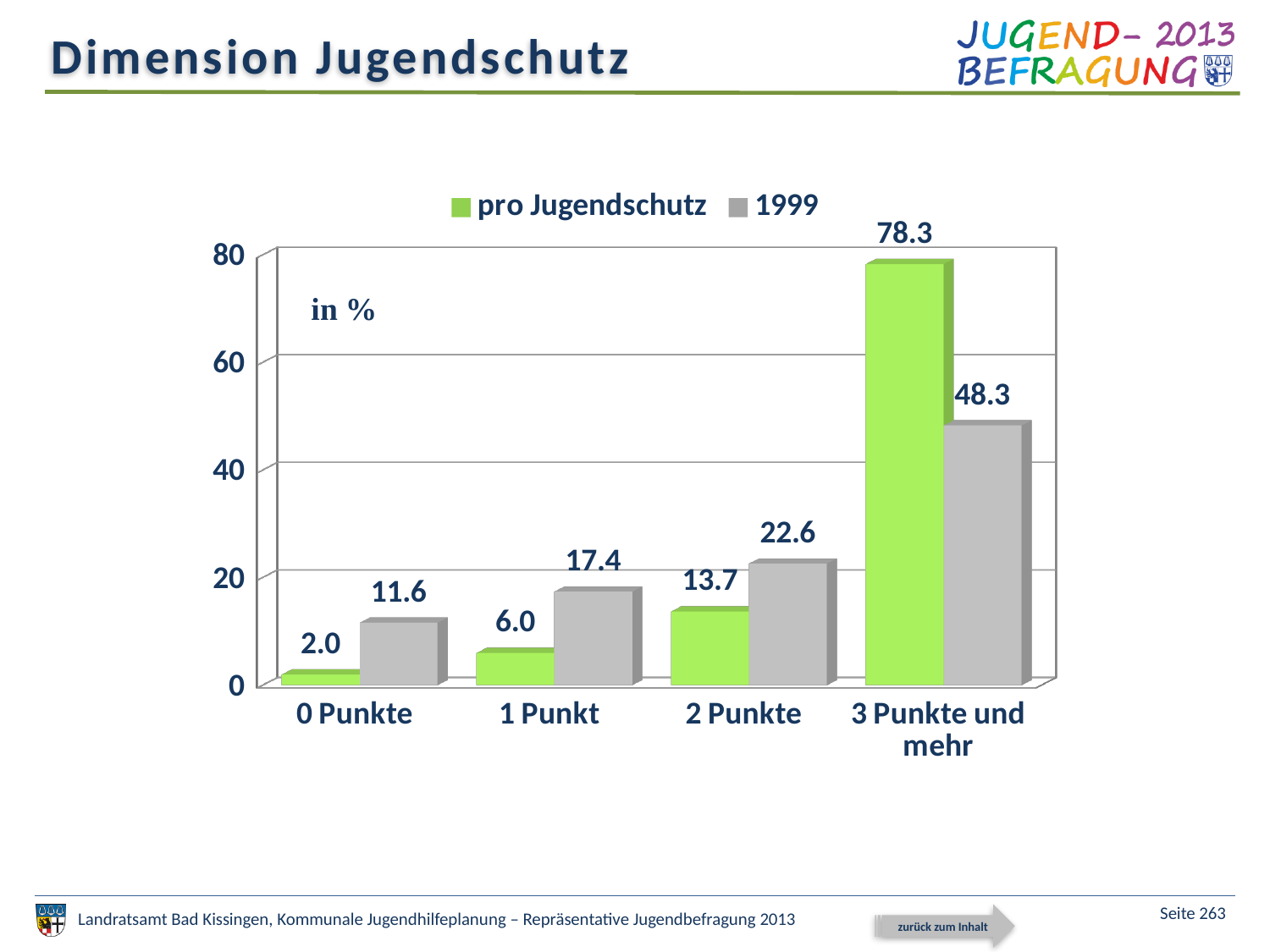
What is the value for the 1999 series in the "2 Punkte" category? 22.6 In the "2 Punkte" category, which series has the larger value, "pro Jugendschutz" or 1999? 1999 What is the value for "pro Jugendschutz" in the "1 Punkt" category? 6.0 How many categories are shown on the x axis? 4 Which colour represents the 1999 series in the chart? Grey How many series does the legend list? 2 Which category has the highest value for the "pro Jugendschutz" series? 3 Punkte und mehr What is the value for the 1999 series in the "0 Punkte" category? 11.6 What kind of chart is shown on the slide? Bar chart Which category has the lowest value for the 1999 series? 0 Punkte What is the difference between the "pro Jugendschutz" and 1999 values in the "3 Punkte und mehr" category? 30.0 What is the value for "pro Jugendschutz" in the "3 Punkte und mehr" category? 78.3